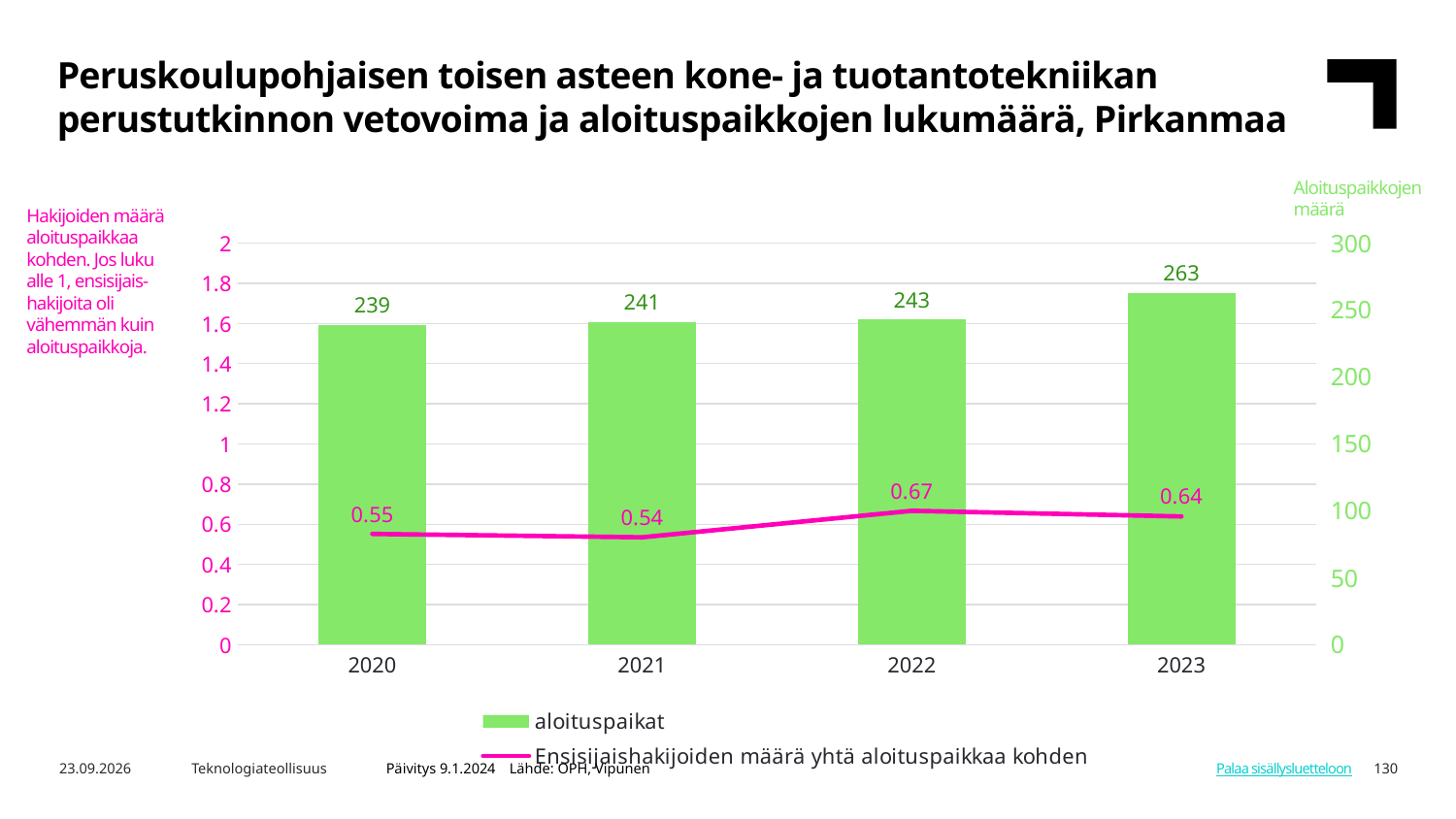
Which year has the lowest value of Ensisijaishakijoiden määrä yhtä aloituspaikkaa kohden? 2021 What is the difference in aloituspaikat between 2023 and 2022? 20 How many years are shown on the x axis? 4 Does the aloituspaikat series rise or fall from 2020 to 2023? rise How many series does the legend list? 2 What is the value of aloituspaikat for 2023? 263 Is the value of aloituspaikat for 2021 greater or less than 200? greater What colour are the aloituspaikat bars? green Which year has the highest value of aloituspaikat? 2023 What is the value of Ensisijaishakijoiden määrä yhtä aloituspaikkaa kohden for 2022? 0.67 Is the value of Ensisijaishakijoiden määrä yhtä aloituspaikkaa kohden higher in 2022 or in 2020? 2022 What is the value of aloituspaikat for 2020? 239